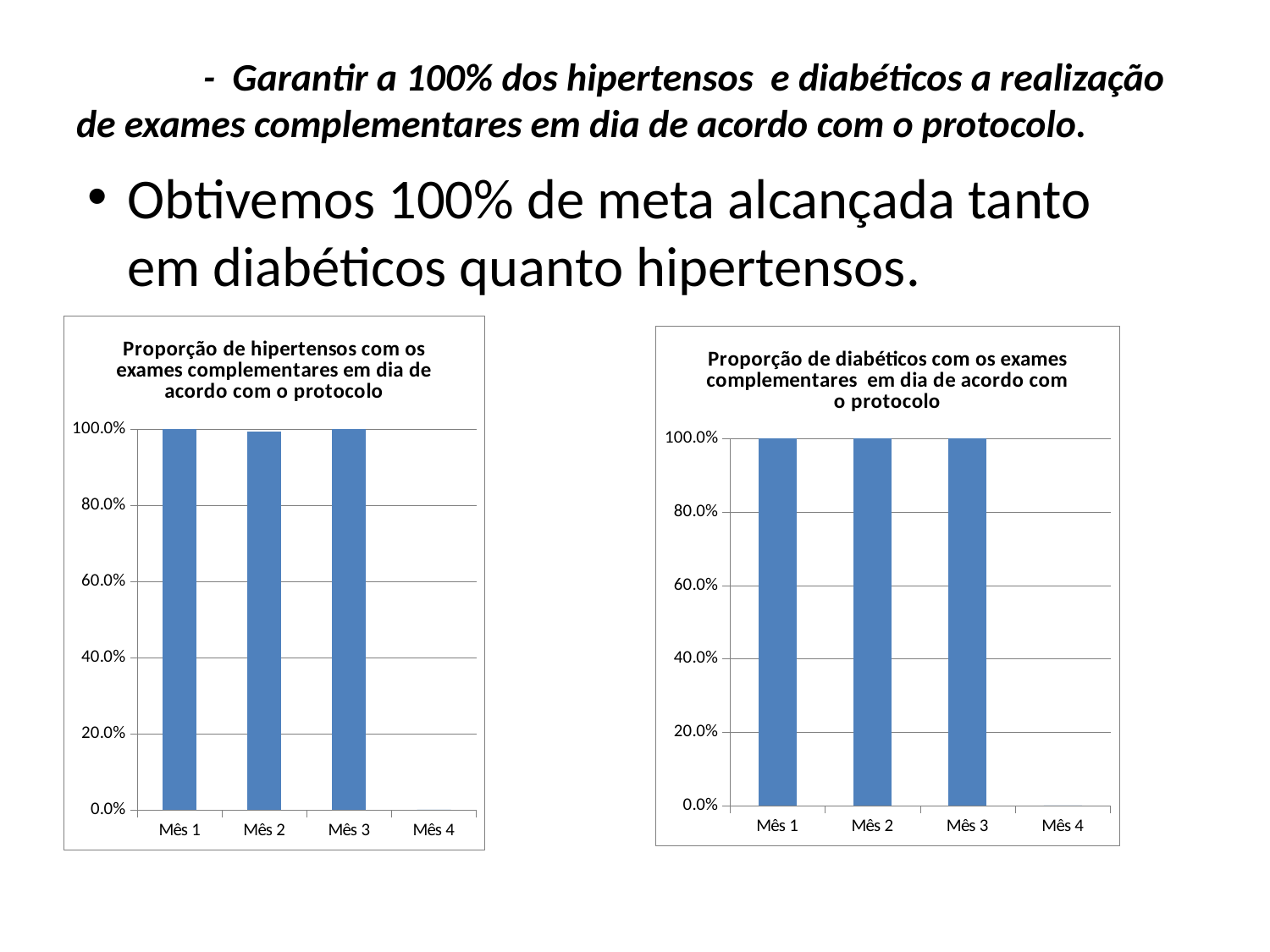
What colour are the bars in the left chart (hipertensos)? blue What kind of chart is the right chart, 'Proporção de diabéticos com os exames complementares em dia de acordo com o protocolo'? bar chart In the left chart (hipertensos), is the value for Mês 3 greater or less than 60.0%? greater In the right chart (diabéticos), is the value for Mês 2 greater or less than 80.0%? greater In the right chart (diabéticos), which category has the lowest value? Mês 4 What kind of chart is the left chart, 'Proporção de hipertensos com os exames complementares em dia de acordo com o protocolo'? bar chart In the left chart (hipertensos), how many categories are shown on the x axis? 4 In the left chart (hipertensos), which category has the lowest value? Mês 4 In the right chart (diabéticos), what is the value for Mês 1? 100.0% In the right chart (diabéticos), what is the value for Mês 3? 100.0% In the left chart (hipertensos), is the value for Mês 1 greater or less than 80.0%? greater In the right chart (diabéticos), how many categories are shown on the x axis? 4